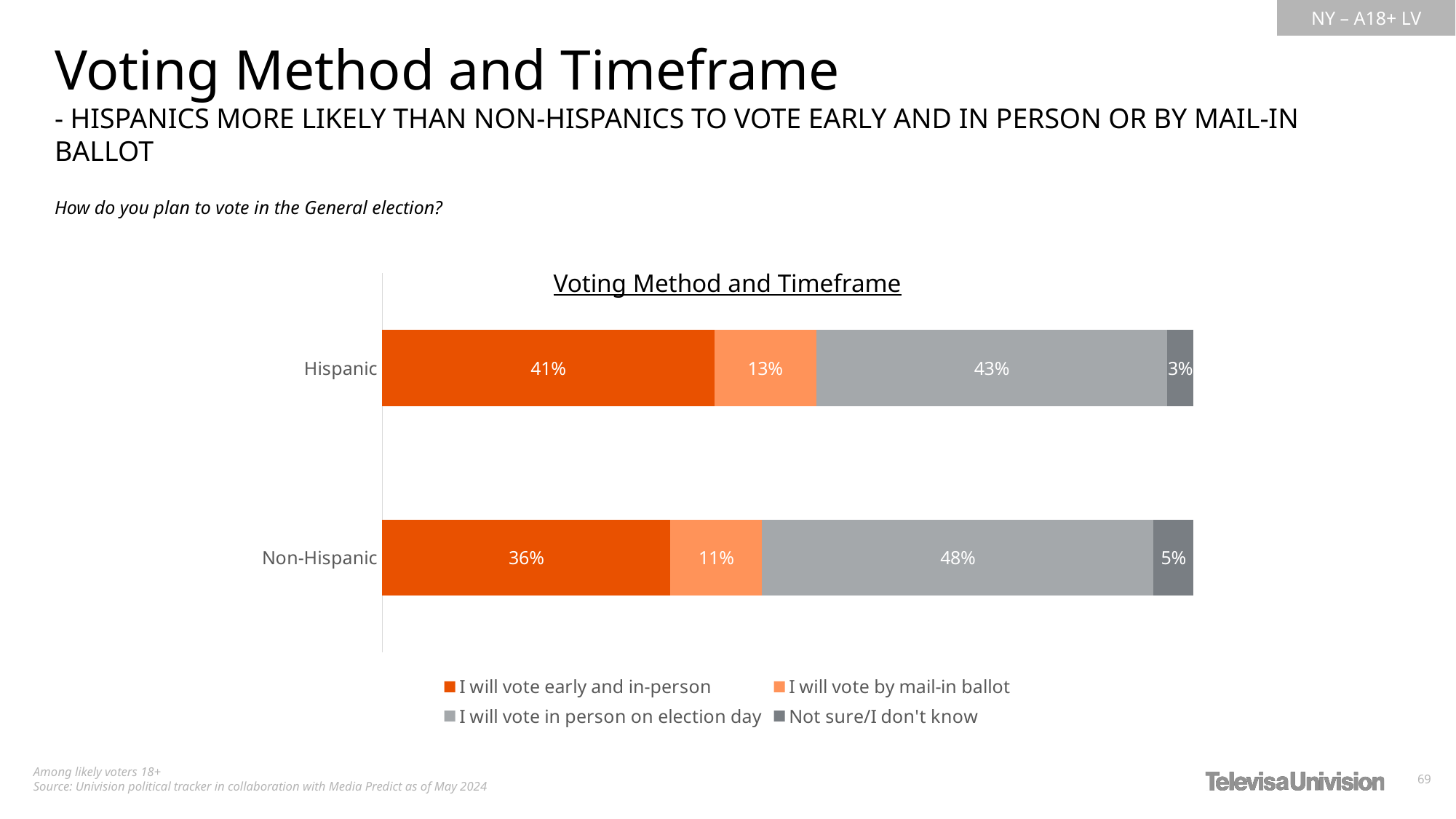
What type of chart is shown on the slide? Stacked bar chart Which voting method has the largest share among Hispanic respondents? I will vote in person on election day What is the difference between the Hispanic and Non-Hispanic shares for 'I will vote by mail-in ballot'? 2 percentage points Which response has the smallest share among Non-Hispanic respondents? Not sure/I don't know What is the difference between the Non-Hispanic and Hispanic shares for 'I will vote in person on election day'? 5 percentage points Which group has the higher share saying they will vote in person on election day, Hispanic or Non-Hispanic? Non-Hispanic What percentage of Hispanic respondents say they will vote by mail-in ballot? 13% What percentage of Non-Hispanic respondents answered 'Not sure/I don't know'? 5% What percentage of Non-Hispanic respondents say they will vote in person on election day? 48% What percentage of Hispanic respondents say they will vote early and in-person? 41% Which group has the higher share saying they will vote early and in-person, Hispanic or Non-Hispanic? Hispanic How many series does the legend list? 4